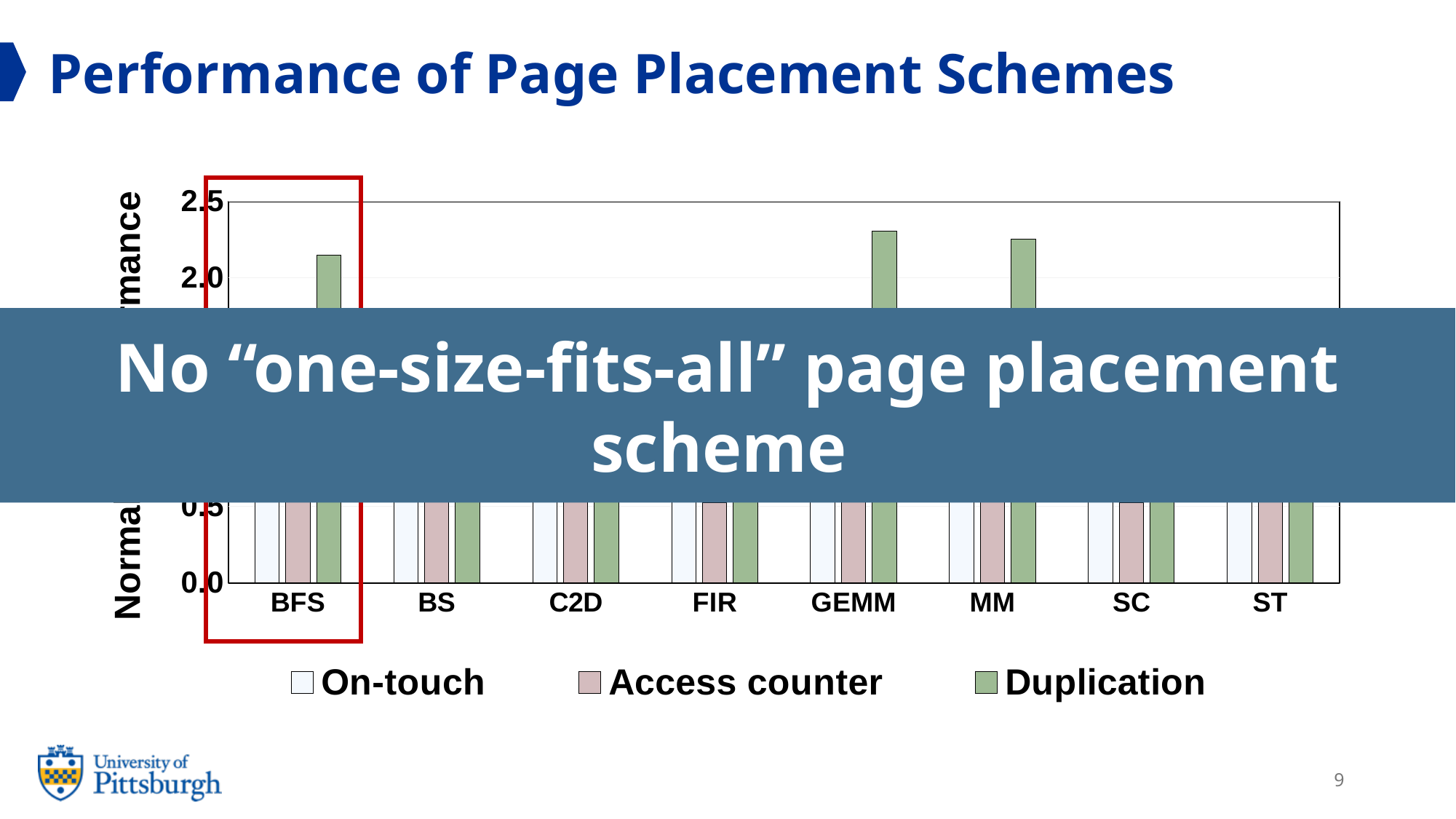
Is the Duplication value for BFS greater or less than 2.0? greater What is the title of the slide containing the chart? Performance of Page Placement Schemes Is the Duplication value for GEMM greater or less than 2.0? greater Which series is shown in green in the legend? Duplication Is the Duplication value for MM greater or less than 2.0? greater How many benchmark categories are shown on the x axis? 8 Which category has the highest Duplication value? GEMM What kind of chart is shown on the slide? bar chart Which is larger, the Duplication value for BFS or for GEMM? GEMM How many series does the legend list? 3